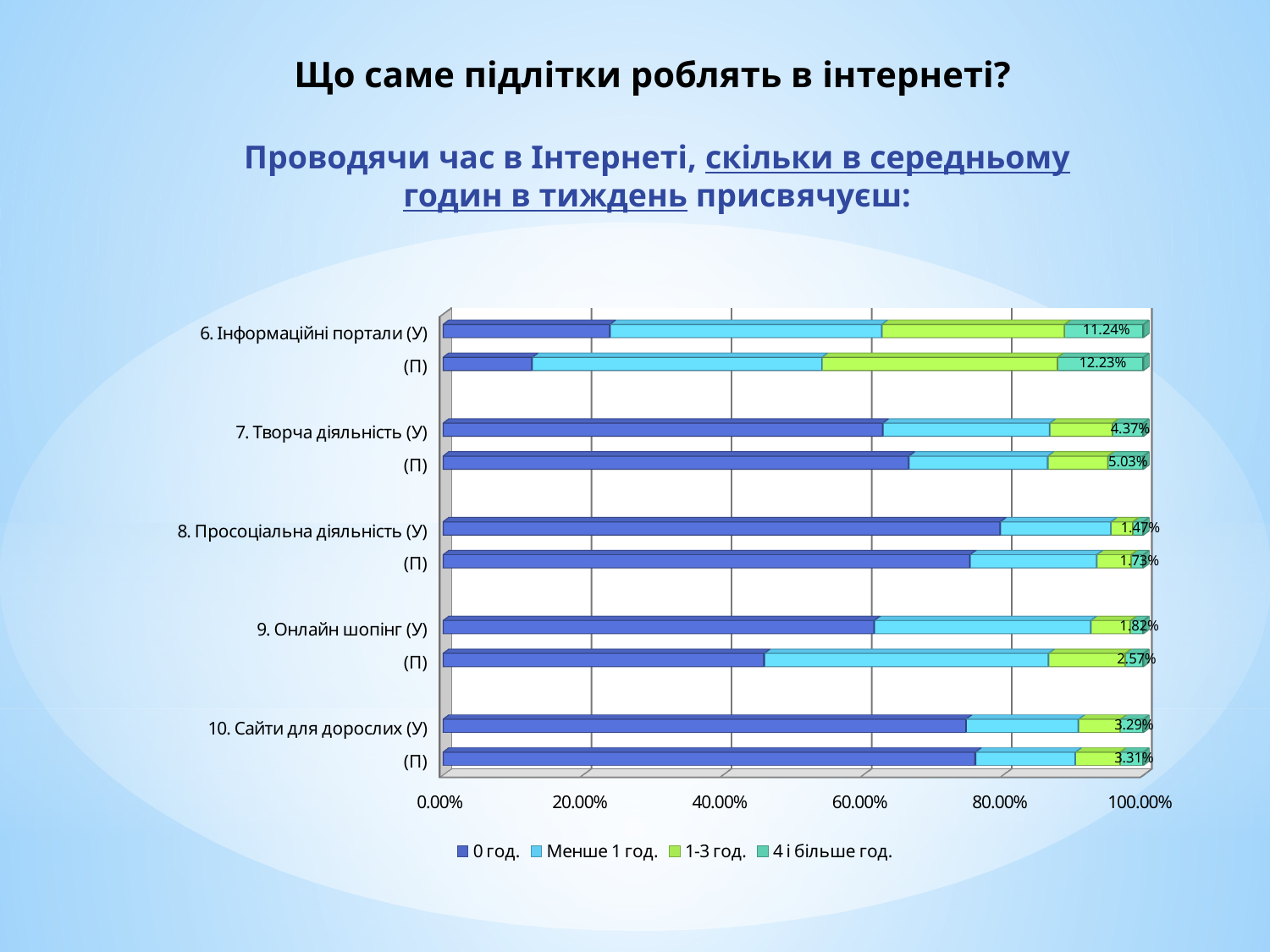
What kind of chart is shown on the slide? Stacked bar chart What is the difference between the "4 і більше год." values for "6. Інформаційні портали (П)" and "6. Інформаційні портали (У)"? 0.99% Is the "0 год." value for "6. Інформаційні портали (У)" greater or less than 40.00%? less Which bar has the highest labelled value for the "4 і більше год." series? 6. Інформаційні портали (П) Which bar has the lowest labelled value for the "4 і більше год." series? 8. Просоціальна діяльність (У) How many bars are plotted in the chart? 10 Which is larger for the "4 і більше год." series: "7. Творча діяльність (У)" or "7. Творча діяльність (П)"? 7. Творча діяльність (П) What is the value of the "4 і більше год." series for "6. Інформаційні портали (У)"? 11.24% What is the value of the "4 і більше год." series for "7. Творча діяльність (П)"? 5.03% How many series does the legend list? 4 Is the "0 год." value for "8. Просоціальна діяльність (У)" greater or less than 60.00%? greater What is the value of the "4 і більше год." series for "9. Онлайн шопінг (П)"? 2.57%